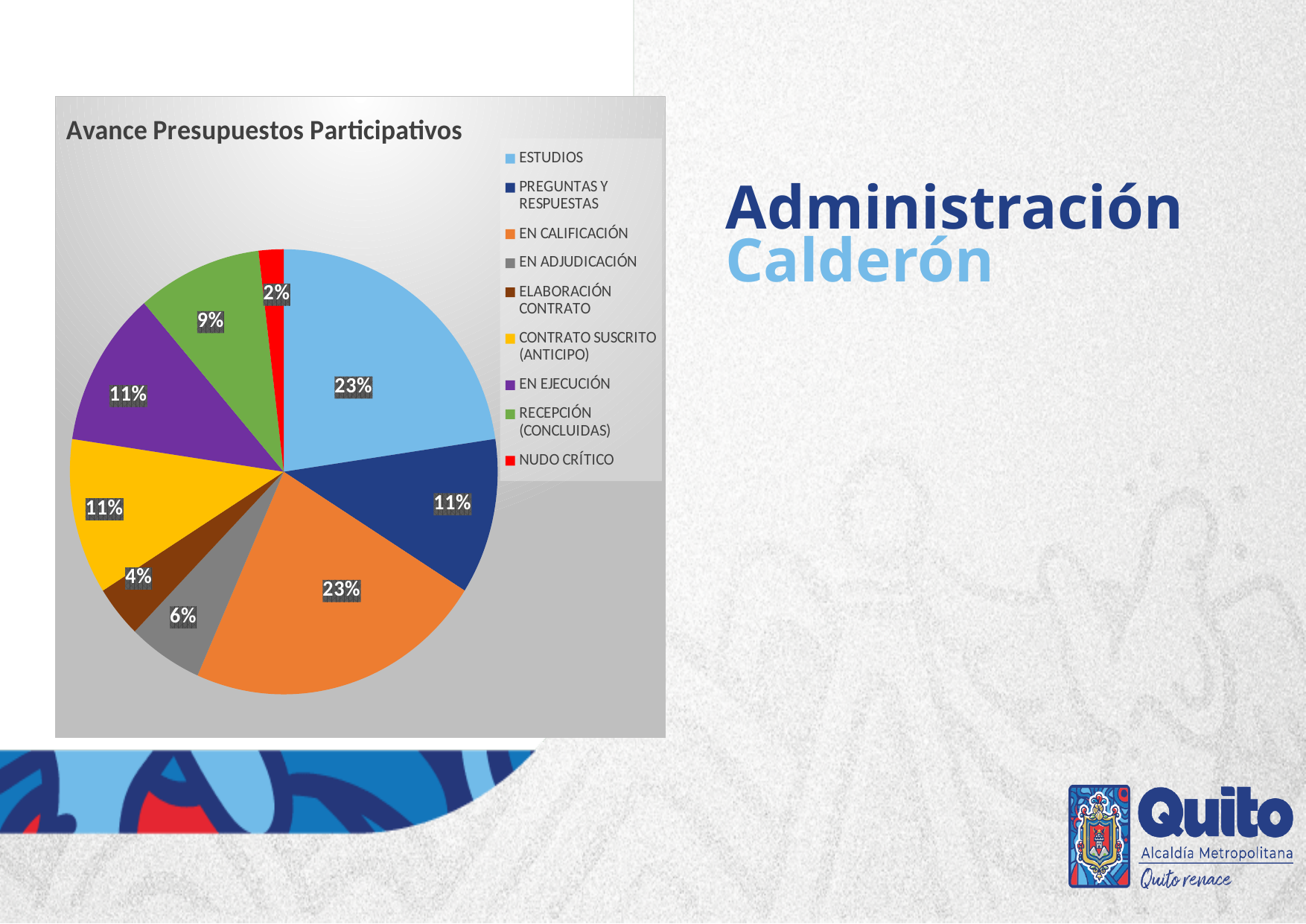
What percentage is shown for ELABORACIÓN CONTRATO? 4% What is the title of the chart? Avance Presupuestos Participativos What percentage is shown for EN ADJUDICACIÓN? 6% What percentage is shown for NUDO CRÍTICO? 2% What colour is the slice for CONTRATO SUSCRITO (ANTICIPO)? yellow Which is larger, the share for RECEPCIÓN (CONCLUIDAS) or the share for EN ADJUDICACIÓN? RECEPCIÓN (CONCLUIDAS) Which category has the smallest slice of the pie? NUDO CRÍTICO What is the difference between the EN CALIFICACIÓN share and the EN EJECUCIÓN share? 12% How many categories does the legend list? 9 What percentage of the pie does ESTUDIOS represent? 23% What kind of chart is shown on the slide? pie chart What percentage is shown for RECEPCIÓN (CONCLUIDAS)? 9%